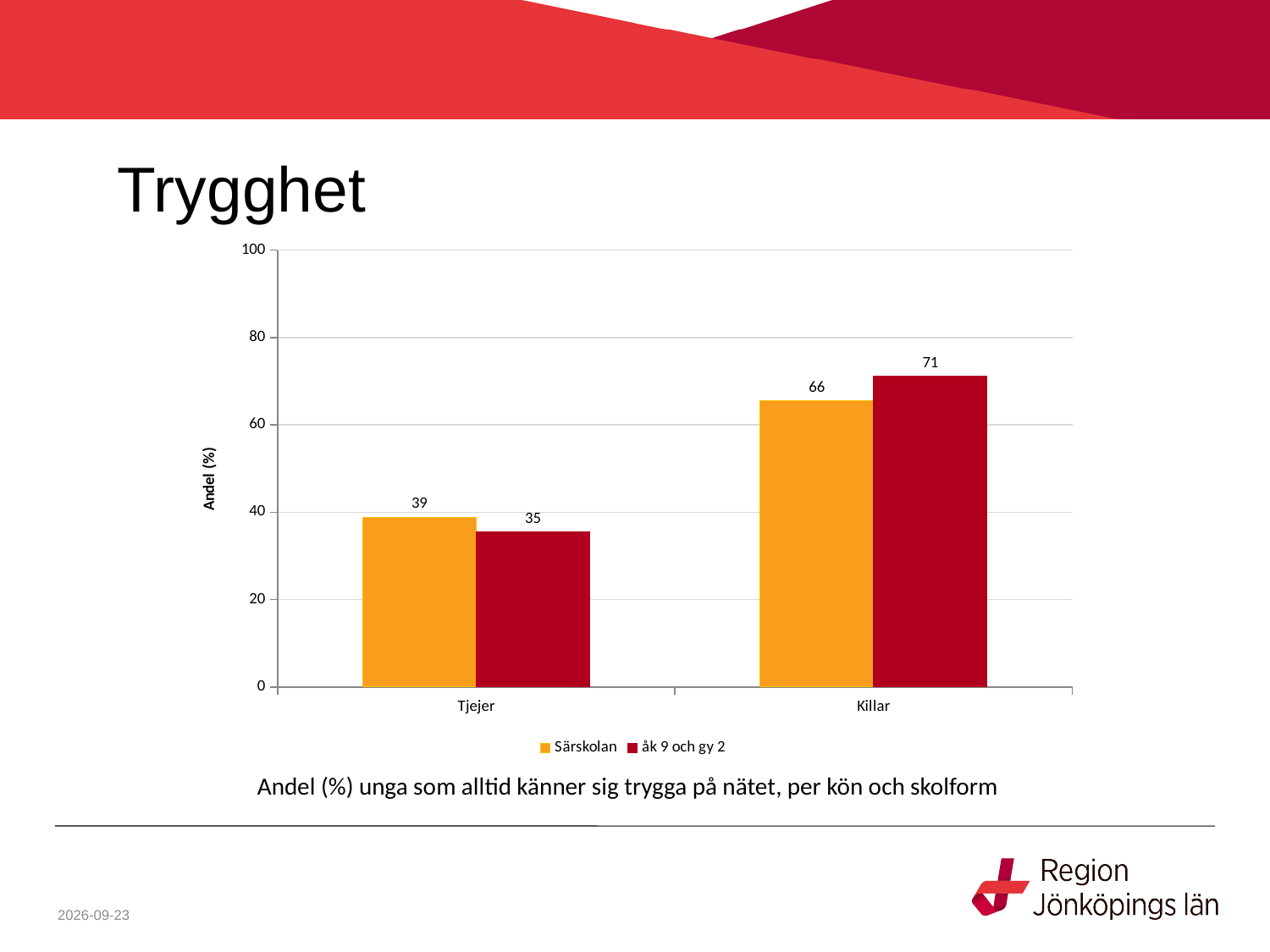
Which category has the highest value for the Särskolan series? Killar What is the value for åk 9 och gy 2 in the Tjejer category? 35 How many categories are shown on the x axis? 2 What kind of chart is shown on the slide? Bar chart What is the value for Särskolan in the Killar category? 66 How many series does the legend list? 2 What is the difference between the Särskolan and åk 9 och gy 2 values for Killar? 5 What is the value for Särskolan in the Tjejer category? 39 Which category has the lowest value for the åk 9 och gy 2 series? Tjejer What is the value for åk 9 och gy 2 in the Killar category? 71 What is the difference between the Särskolan values for Killar and Tjejer? 27 For Tjejer, which series has the larger value, Särskolan or åk 9 och gy 2? Särskolan